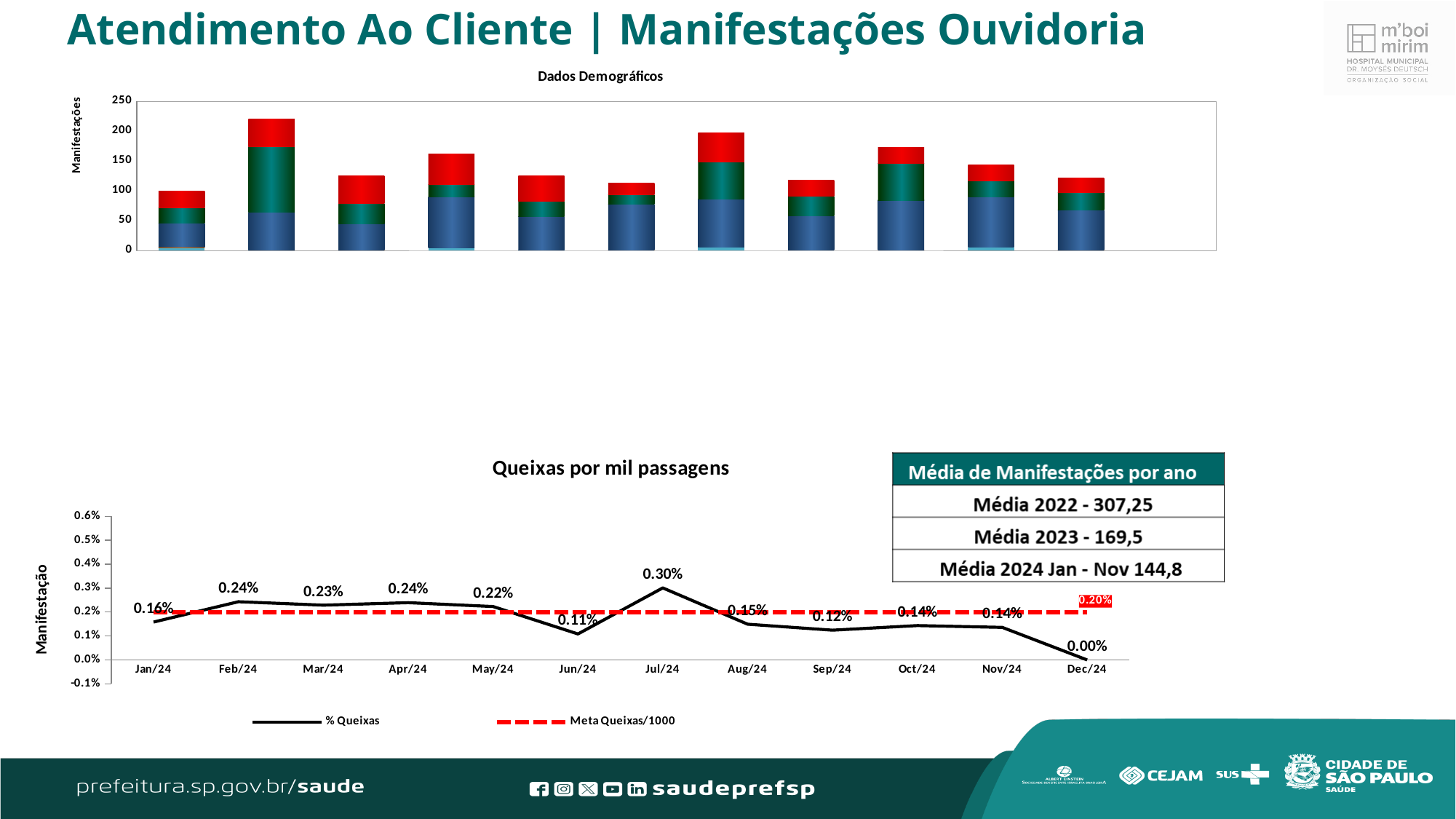
In the 'Queixas por mil passagens' chart, which month has the highest % Queixas value? Jul/24 How many series does the legend of the 'Queixas por mil passagens' chart list? 2 In the 'Queixas por mil passagens' chart, what is the difference between the % Queixas values for Jul/24 and Jun/24? 0.19% In the 'Queixas por mil passagens' chart, which month has the lowest % Queixas value? Dec/24 What kind of chart is the 'Dados Demográficos' chart at the top of the slide? bar chart In the 'Queixas por mil passagens' chart, which month has a larger % Queixas value, Feb/24 or Aug/24? Feb/24 In the 'Queixas por mil passagens' chart, is the % Queixas value for Jun/24 greater or less than 0.2%? less How many months are plotted in the 'Queixas por mil passagens' chart? 12 In the 'Queixas por mil passagens' chart, what value is labelled on the dashed Meta Queixas/1000 line? 0.20% What kind of chart is the 'Queixas por mil passagens' chart? line chart In the 'Queixas por mil passagens' chart, what is the % Queixas value for Jan/24? 0.16% In the 'Queixas por mil passagens' chart, what is the % Queixas value for Jul/24? 0.30%